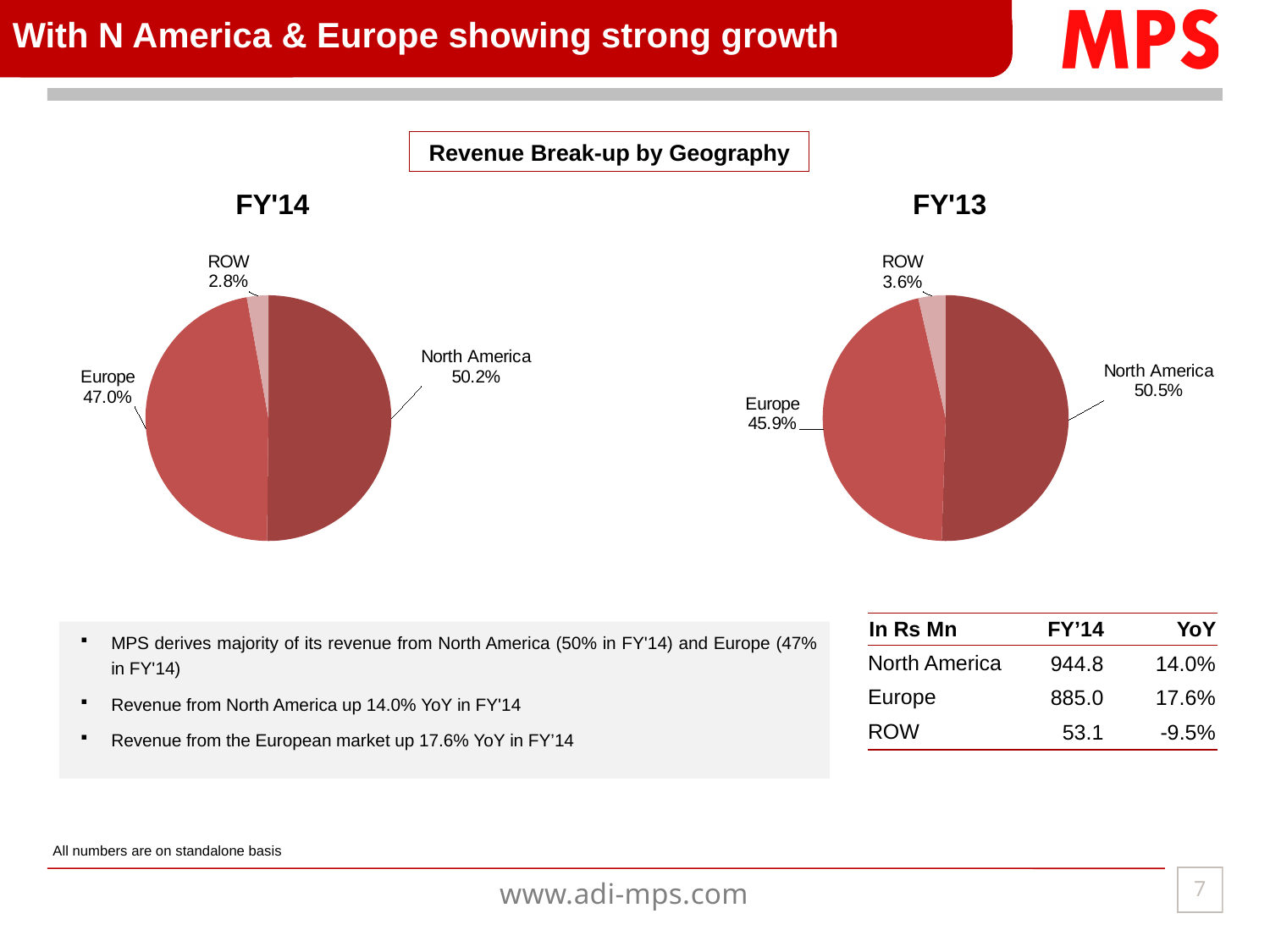
In the FY'14 pie chart, which region has the smallest share? ROW Is Europe's share larger in the FY'14 pie chart or the FY'13 pie chart? FY'14 In the FY'14 pie chart, what share of revenue comes from Europe? 47.0% In the FY'13 pie chart, what share of revenue comes from Europe? 45.9% In the FY'13 pie chart, what share of revenue comes from ROW? 3.6% What type of chart is used to show the FY'13 revenue break-up? Pie chart In the FY'13 pie chart, which region has the largest share? North America In the FY'13 pie chart, what is the difference between the Europe and ROW shares? 42.3% What is the title shown above the two pie charts? Revenue Break-up by Geography How many slices does the FY'14 pie chart have? 3 In the FY'14 pie chart, what is the difference between the North America and Europe shares? 3.2% In the FY'14 pie chart, what share of revenue comes from North America? 50.2%